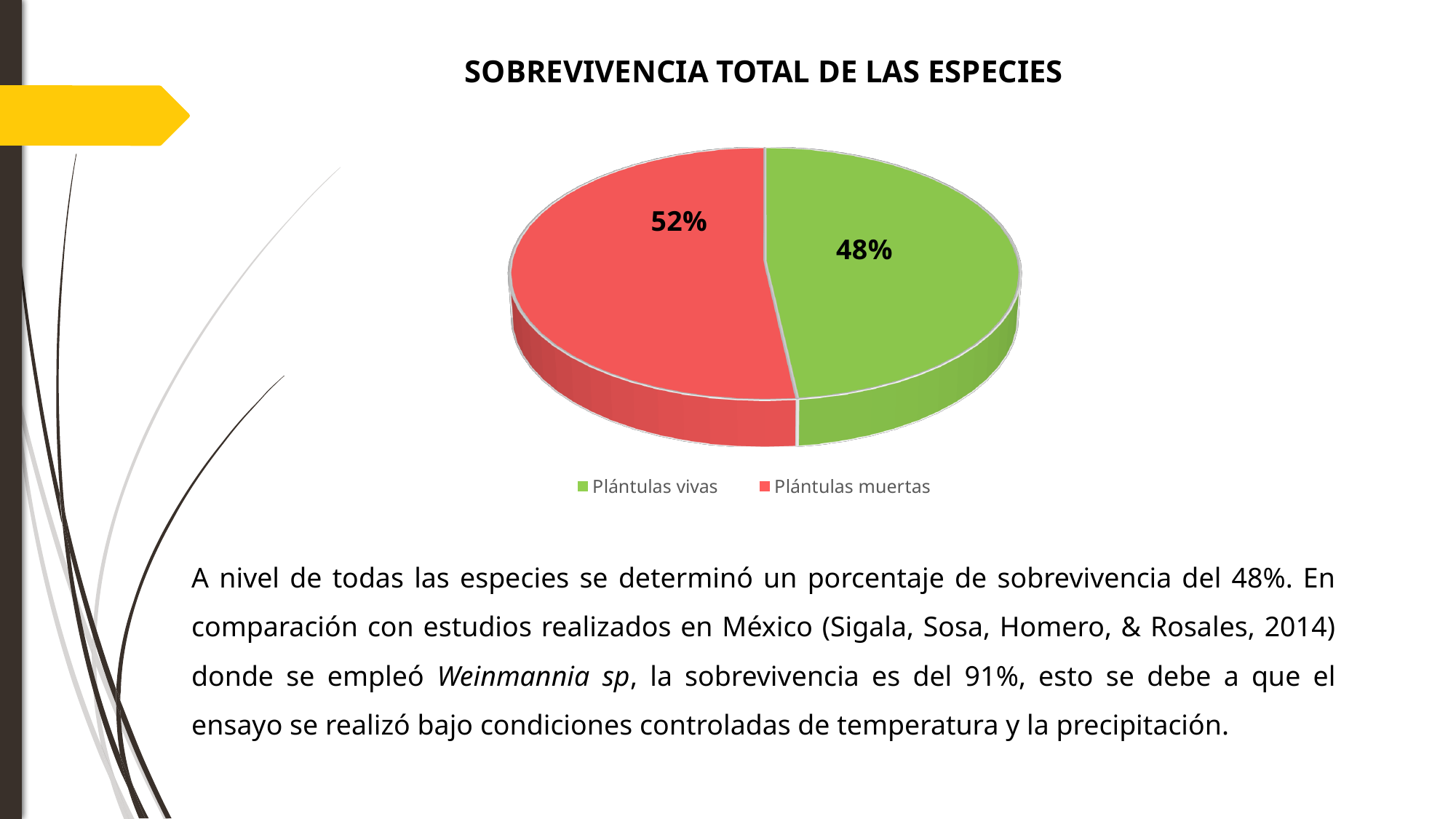
What colour represents Plántulas vivas in the chart? Green What is the title of the chart? SOBREVIVENCIA TOTAL DE LAS ESPECIES What is the difference in percentage points between Plántulas muertas and Plántulas vivas? 4 What type of chart is shown on the slide? Pie chart Is the share for Plántulas vivas larger or smaller than the share for Plántulas muertas? Smaller What percentage of the pie is labelled for Plántulas muertas? 52% Is the share for Plántulas muertas greater or less than 50%? greater What percentage of the pie is labelled for Plántulas vivas? 48% Which category has the larger share of the pie? Plántulas muertas How many slices does the pie chart have? 2 How many entries does the legend list? 2 Which category has the smaller share of the pie? Plántulas vivas